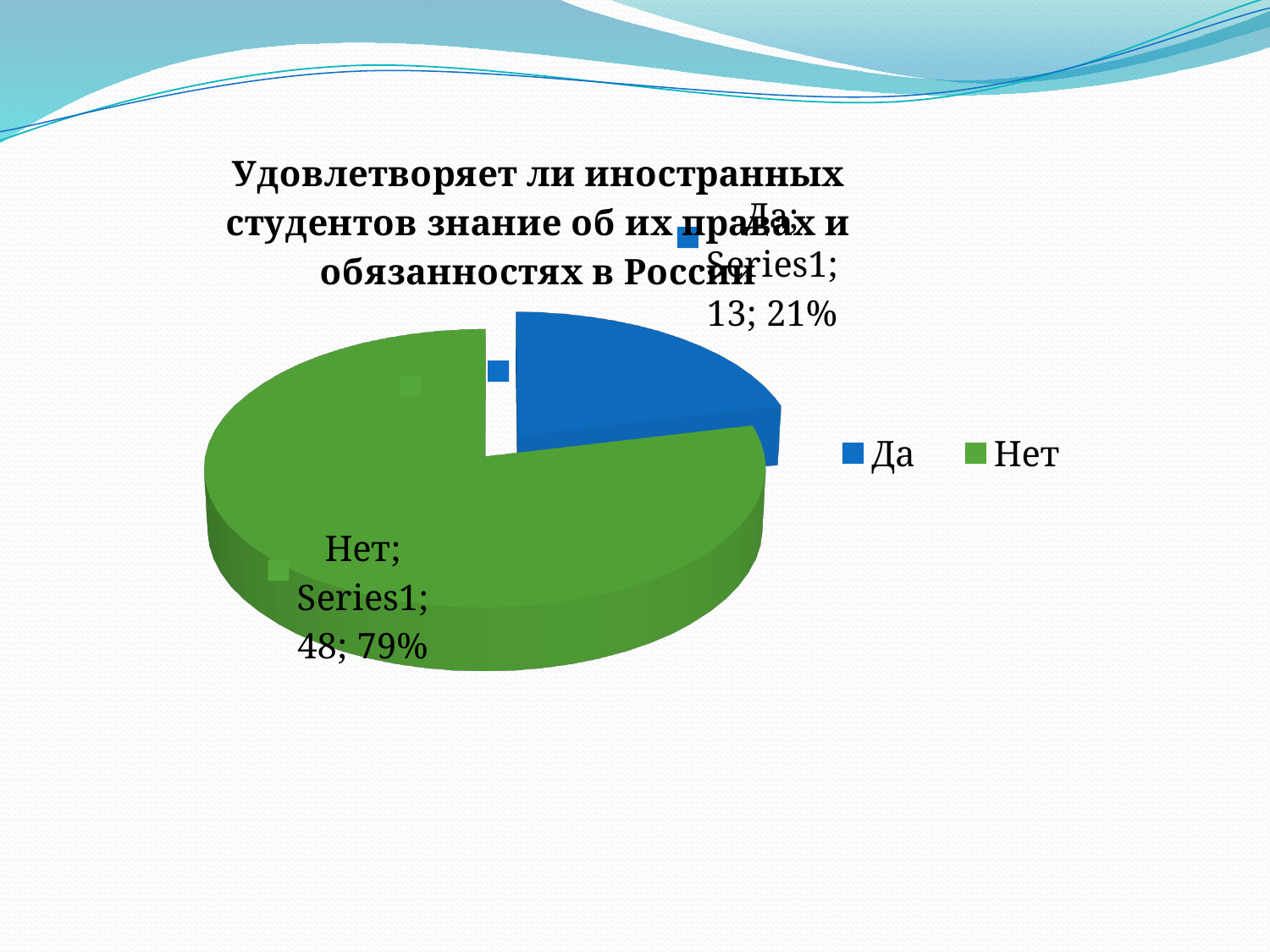
What share of the pie does the "Да" slice represent? 21% What is the value for the "Да" slice? 13 How many entries does the legend list? 2 What is the value for the "Нет" slice? 48 What kind of chart is shown on the slide? pie chart What is the difference between the values for "Нет" and "Да"? 35 How many slices does the pie chart have? 2 What colour is the "Нет" slice? green What share of the pie does the "Нет" slice represent? 79% Which slice is the largest? Нет Which is larger, the value for "Да" or the value for "Нет"? Нет Which slice is the smallest? Да